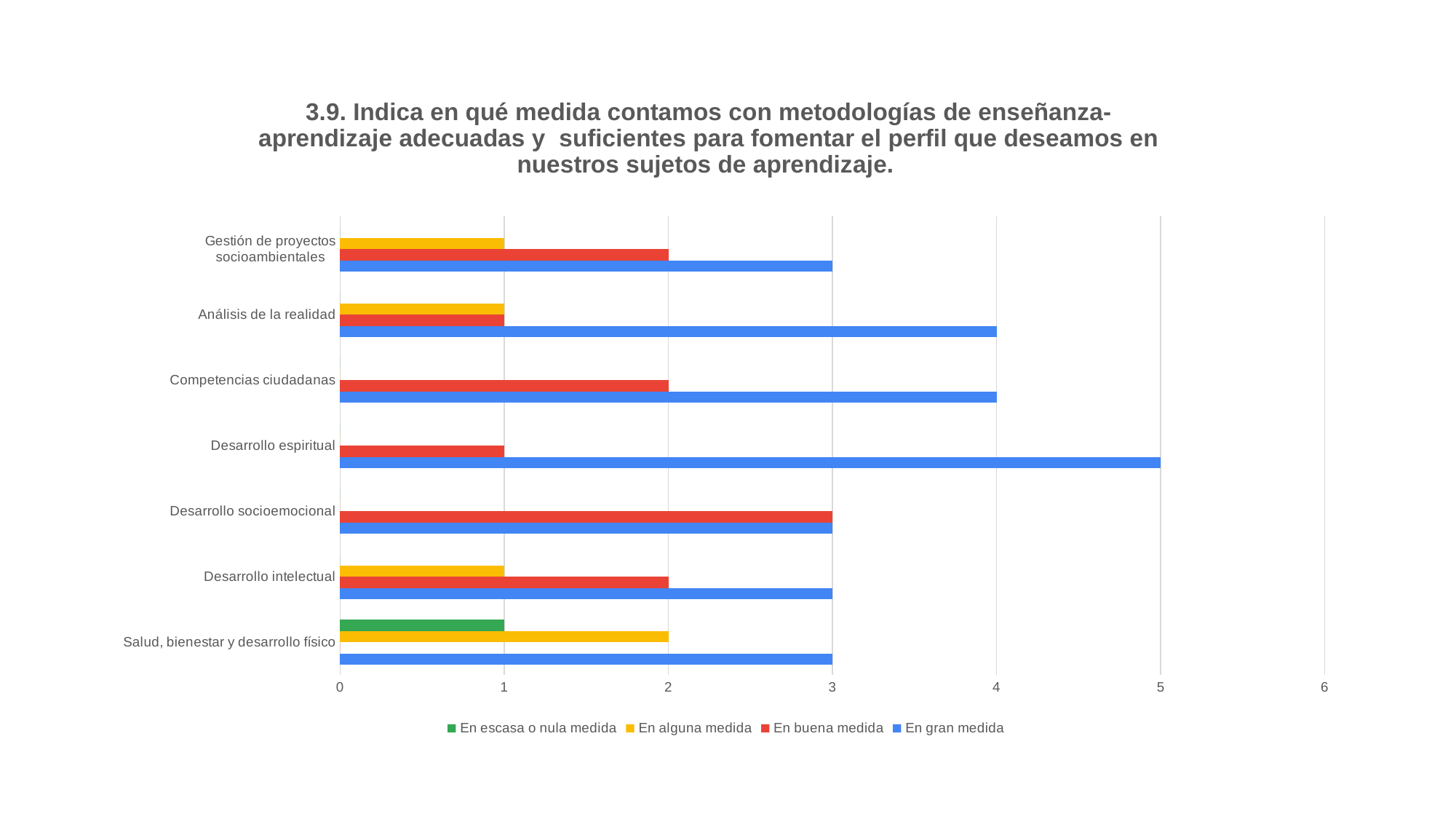
Which category is the only one with a value for 'En escasa o nula medida'? Salud, bienestar y desarrollo físico How many categories are plotted on the chart? 7 What is the value of 'En gran medida' for Desarrollo espiritual? 5 Which is larger: 'En gran medida' for Análisis de la realidad or 'En gran medida' for Gestión de proyectos socioambientales? Análisis de la realidad Which category has the highest value for 'En gran medida'? Desarrollo espiritual What is the difference between 'En gran medida' for Desarrollo espiritual and 'En gran medida' for Desarrollo intelectual? 2 Is the value of 'En gran medida' for Competencias ciudadanas greater or less than 3? greater How many series does the legend list? 4 What kind of chart is shown on the slide? bar chart What is the value of 'En buena medida' for Desarrollo socioemocional? 3 What is the value of 'En alguna medida' for Salud, bienestar y desarrollo físico? 2 Which legend entry is shown in blue? En gran medida